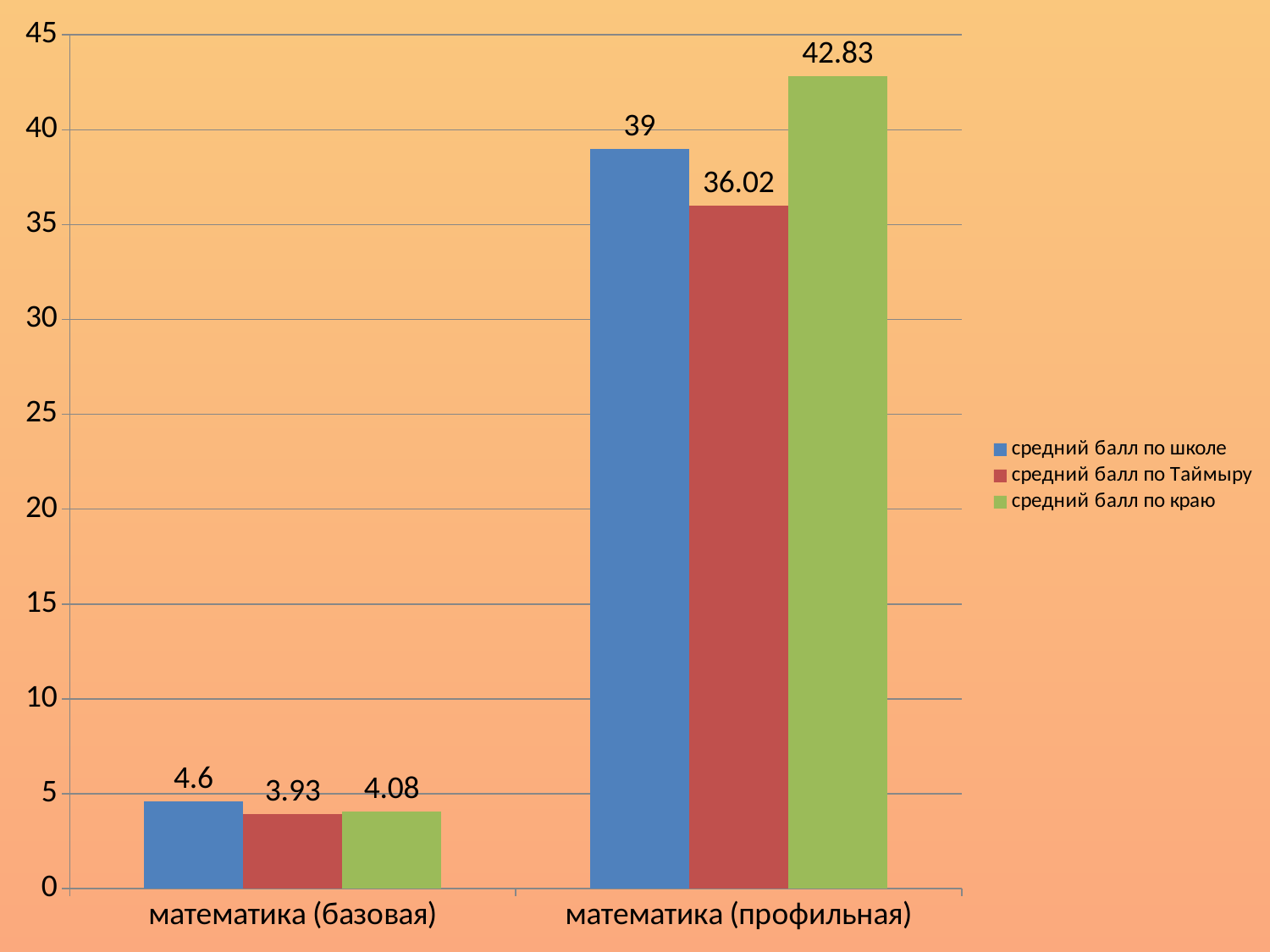
How many categories are shown on the x axis? 2 What is the value of 'средний балл по Таймыру' for 'математика (профильная)'? 36.02 Is the value of 'средний балл по школе' for 'математика (профильная)' greater or less than 40? less What is the value of 'средний балл по школе' for 'математика (базовая)'? 4.6 Which series has the highest value for 'математика (профильная)'? средний балл по краю Which is larger for 'математика (профильная)': 'средний балл по школе' or 'средний балл по Таймыру'? средний балл по школе Which series has the lowest value for 'математика (базовая)'? средний балл по Таймыру How many series does the legend list? 3 What is the difference between 'средний балл по краю' and 'средний балл по школе' for 'математика (профильная)'? 3.83 What is the value of 'средний балл по краю' for 'математика (базовая)'? 4.08 What kind of chart is shown on the slide? bar chart What is the value of 'средний балл по краю' for 'математика (профильная)'? 42.83